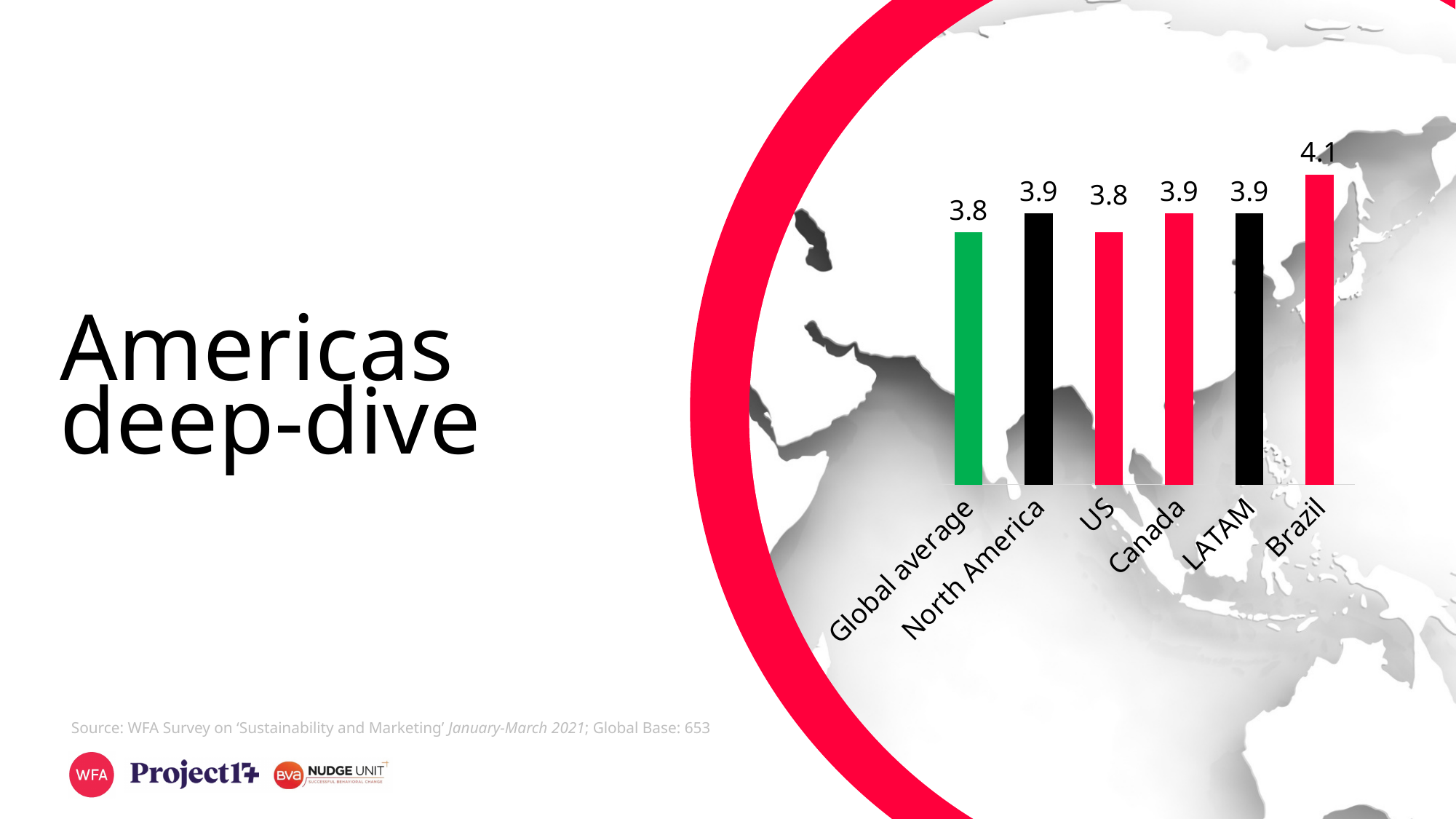
What is the value for LATAM? 3.9 What colour is the bar for the Global average? Green Which category has the highest value? Brazil How many categories are shown in the chart? 6 What is the difference between the values for Brazil and the Global average? 0.3 What is the value for Brazil? 4.1 Which is larger, the value for Brazil or the value for North America? Brazil What is the value for Canada? 3.9 What kind of chart is shown on the slide? Bar chart What is the value for the Global average? 3.8 What is the value for the US? 3.8 What is the difference between the values for Canada and the US? 0.1